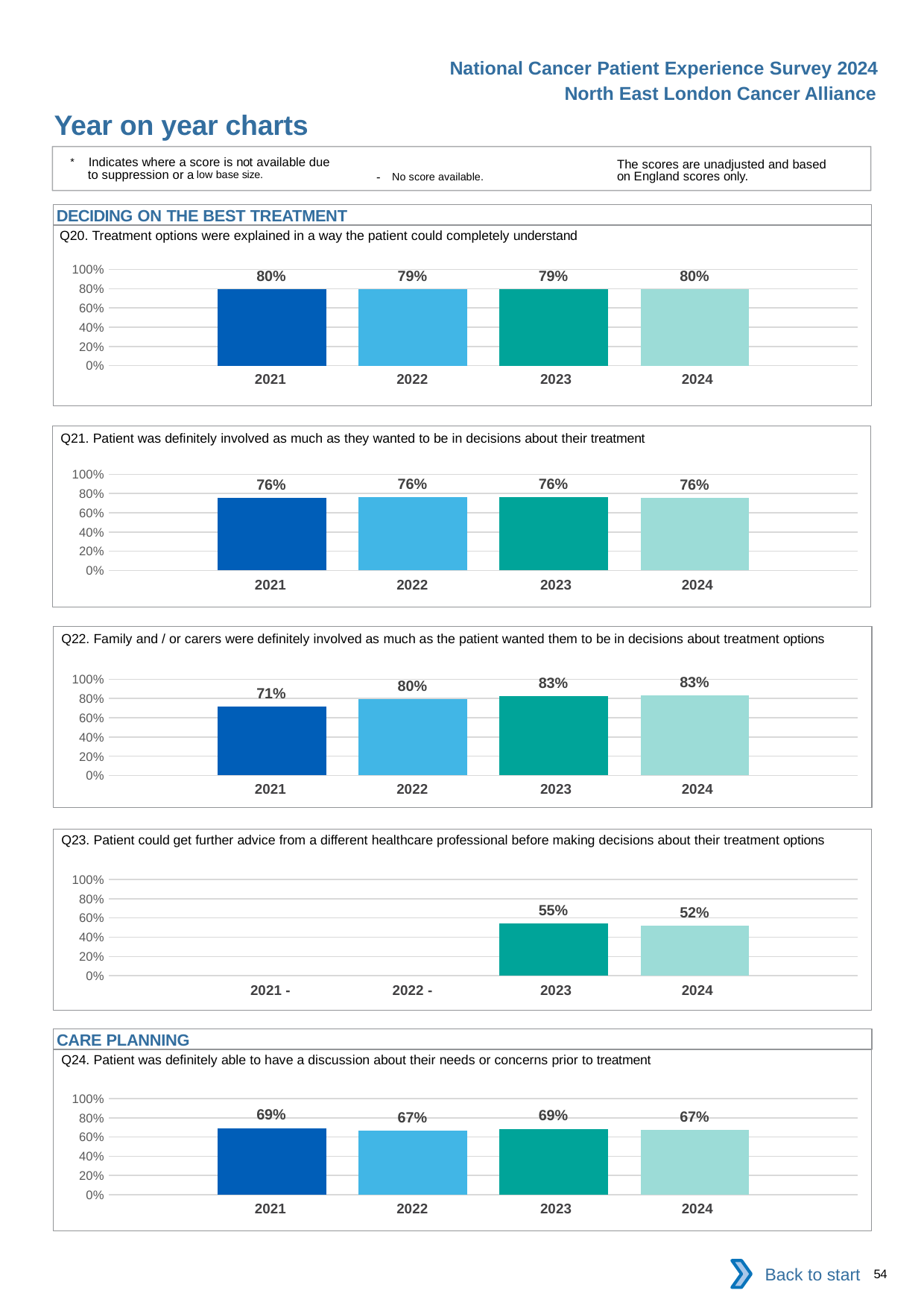
In the Q21 chart, what is the value for 2024? 76% In the Q22 chart, what is the difference between the 2024 value and the 2021 value? 12% In the Q22 chart, which year has the lowest value? 2021 What kind of chart is the Q20 chart? bar chart In the Q20 chart, what is the value for 2021? 80% In the Q23 chart, which year has the higher value, 2023 or 2024? 2023 In the Q23 chart, how many years have a bar plotted? 2 In the Q22 chart, do the values rise or fall from 2021 to 2023? rise In the Q24 chart, what is the difference between the 2021 value and the 2022 value? 2% In the Q24 chart, what is the value for 2022? 67% In the Q23 chart, what is the value for 2024? 52% In the Q20 chart, what is the value for 2023? 79%